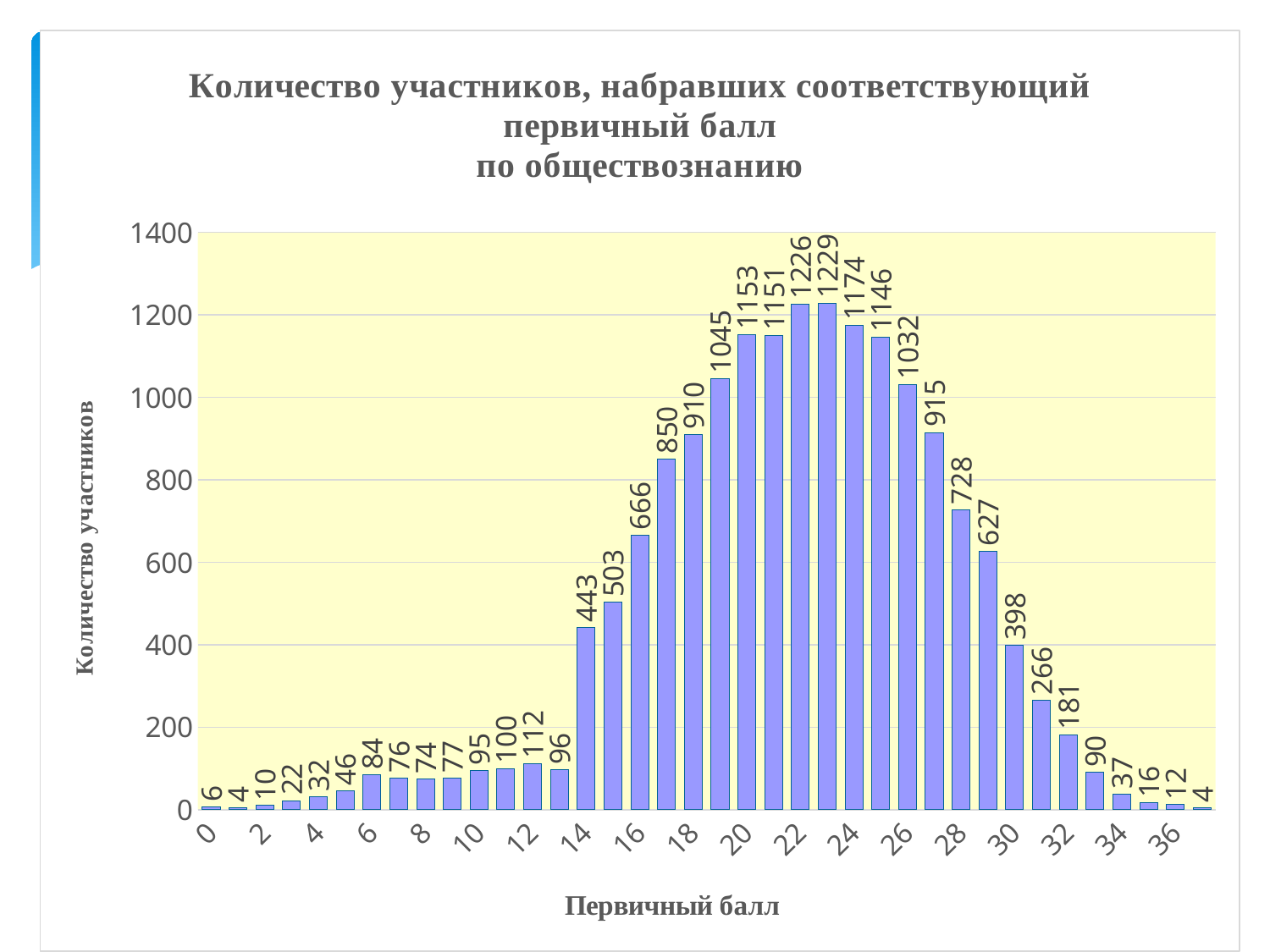
Do the values rise or fall along the x axis from primary score 23 to primary score 37? fall What is the number of participants who scored a primary score of 20? 1153 How many bars are plotted on the chart? 38 What is the difference between the values for primary scores 14 and 13? 347 What is the highest value shown on the chart? 1229 Which primary score has the highest number of participants? 23 Is the value for primary score 16 greater or less than 600? greater What is the value shown for primary score 30? 398 How many participants scored a primary score of 14? 443 Which has more participants: primary score 17 or primary score 27? 27 What type of chart is shown on the slide? bar chart What is the title of the x axis? Первичный балл